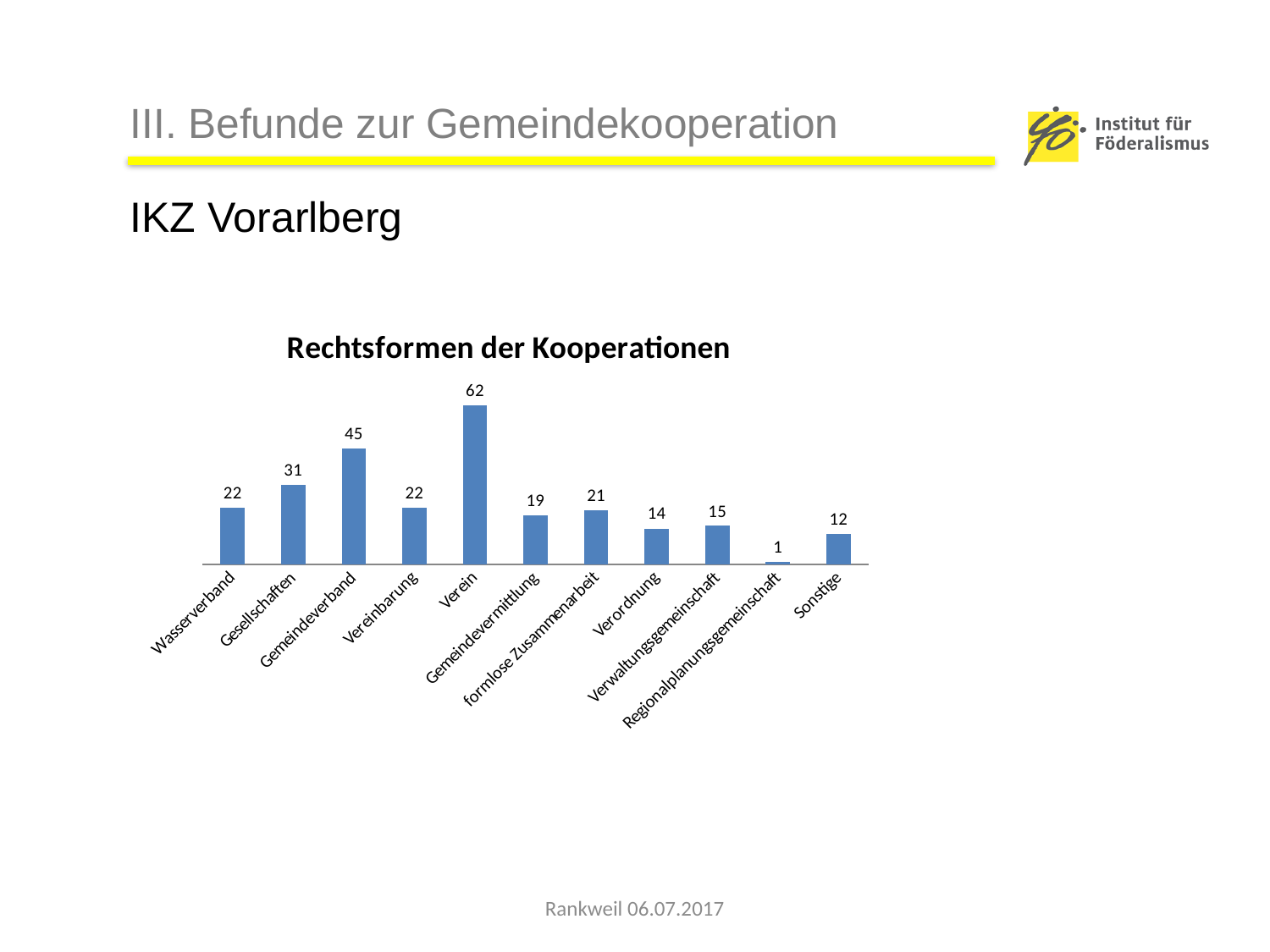
What is the value for Regionalplanungsgemeinschaft? 1 What is the difference between the values for Verein and Gemeindeverband? 17 What kind of chart is shown on the slide? bar chart Which category has the lowest value? Regionalplanungsgemeinschaft What is the value for Verein? 62 Which is larger, the value for Gesellschaften or the value for Vereinbarung? Gesellschaften What is the value for Sonstige? 12 How many categories are shown in the chart? 11 What is the difference between the values for Verwaltungsgemeinschaft and Verordnung? 1 What is the value for Gemeindeverband? 45 Which category has the highest value? Verein What is the title of the chart? Rechtsformen der Kooperationen